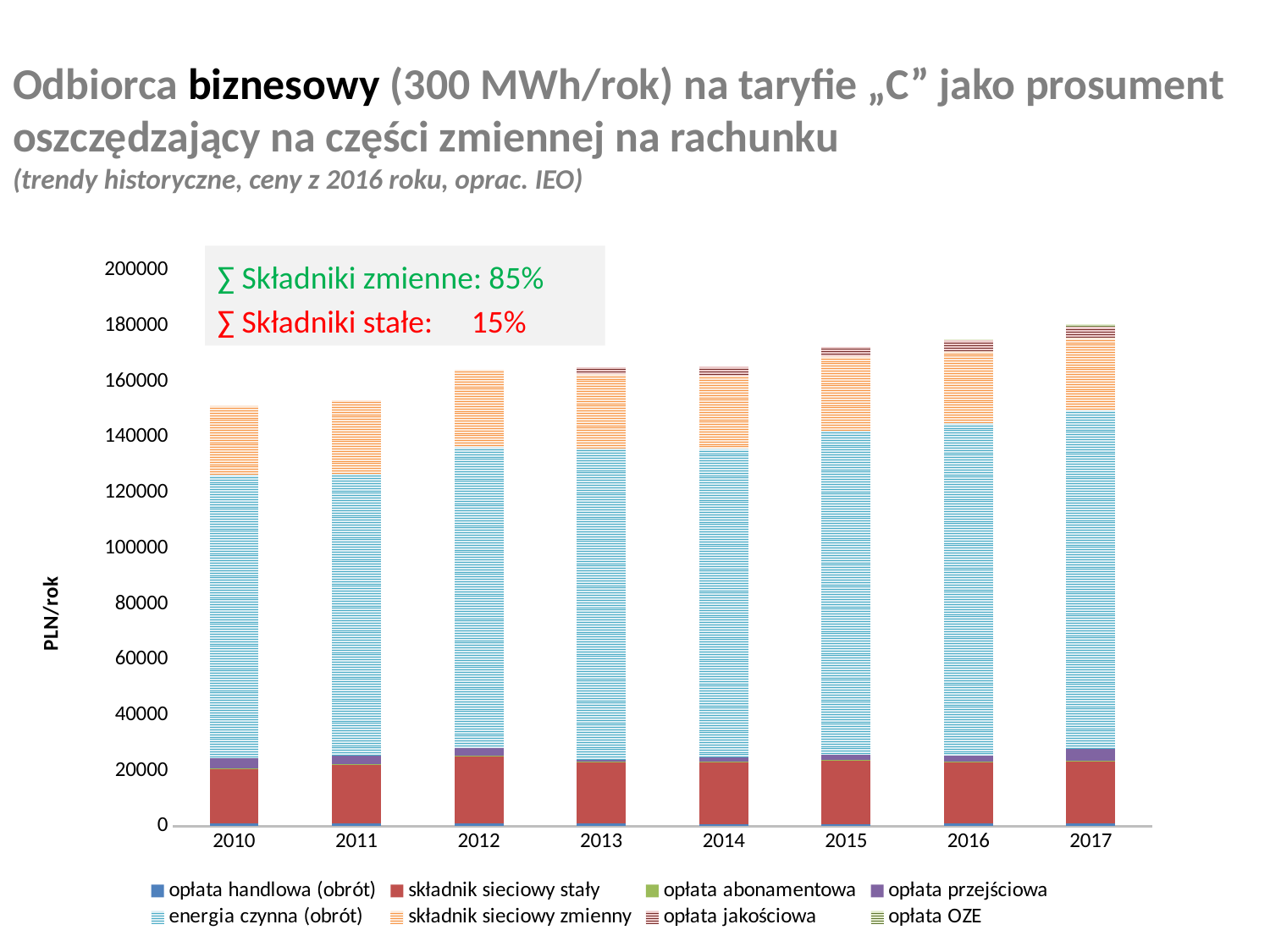
What is the label of the vertical axis? PLN/rok Which year has the lowest total bar? 2010 What kind of chart is shown on the slide? stacked bar chart Is the total bar for 2015 greater or less than 160000? greater Which year has the larger total bar, 2012 or 2011? 2012 According to the text box on the chart, what share do the variable components (Składniki zmienne) make up? 85% Do the total bar heights generally rise or fall from 2010 to 2017? rise How many series does the chart legend list? 8 How many years are shown on the x axis of the chart? 8 Is the total bar for 2011 greater or less than 160000? less Which year has the highest total bar? 2017 Is the total bar for 2010 greater or less than 160000? less